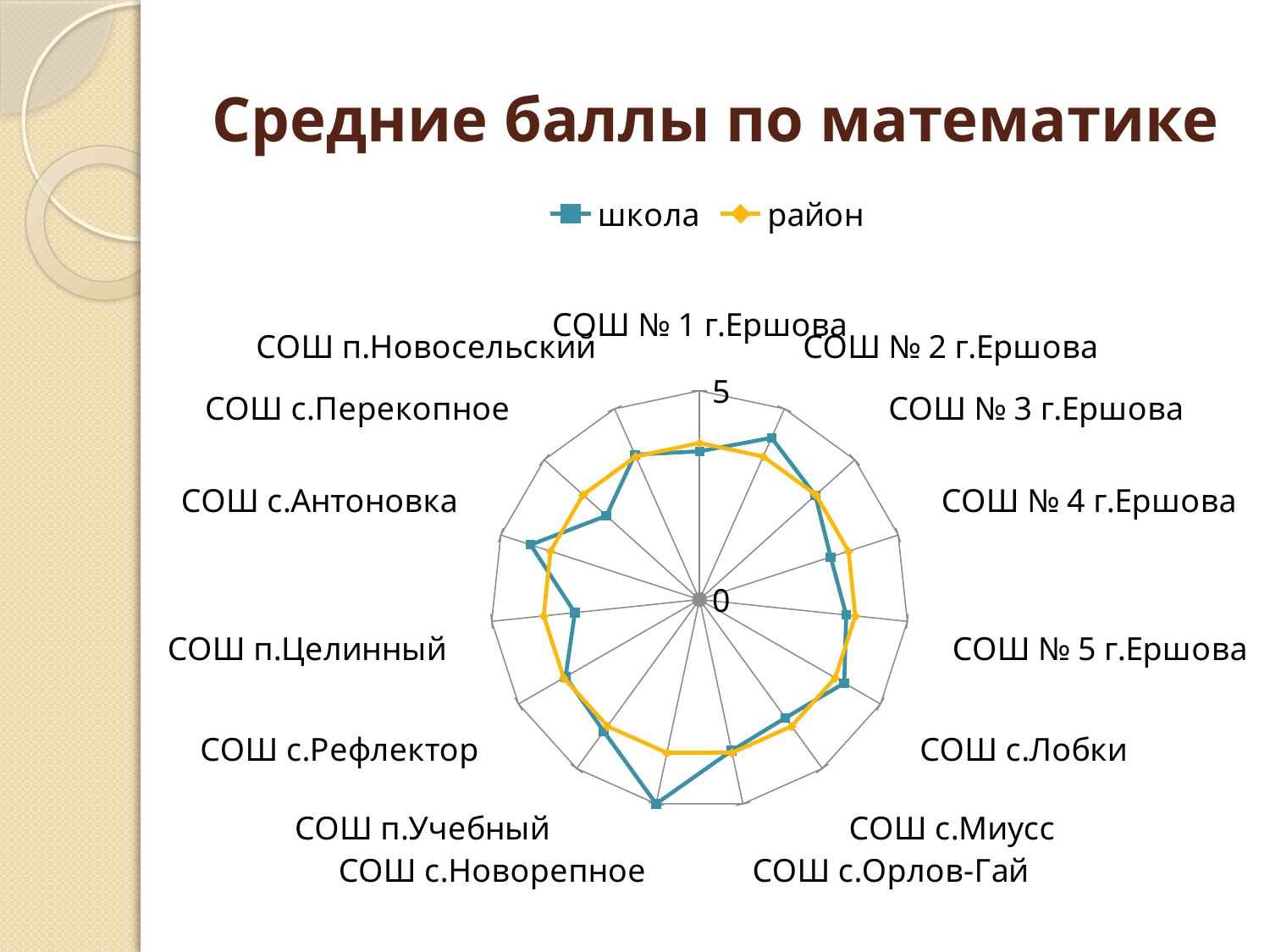
For СОШ с.Новорепное, which series has the larger value, школа or район? школа In the школа series, which is larger: the value for СОШ с.Новорепное or for СОШ с.Перекопное? СОШ с.Новорепное For СОШ с.Перекопное, which series has the larger value, школа or район? район What kind of chart is shown on the slide? radar chart How many schools (categories) are plotted on the chart? 15 What are the two series named in the legend? школа, район What is the title of the chart? Средние баллы по математике Which school has the highest value in the школа series? СОШ с.Новорепное How many series does the legend list? 2